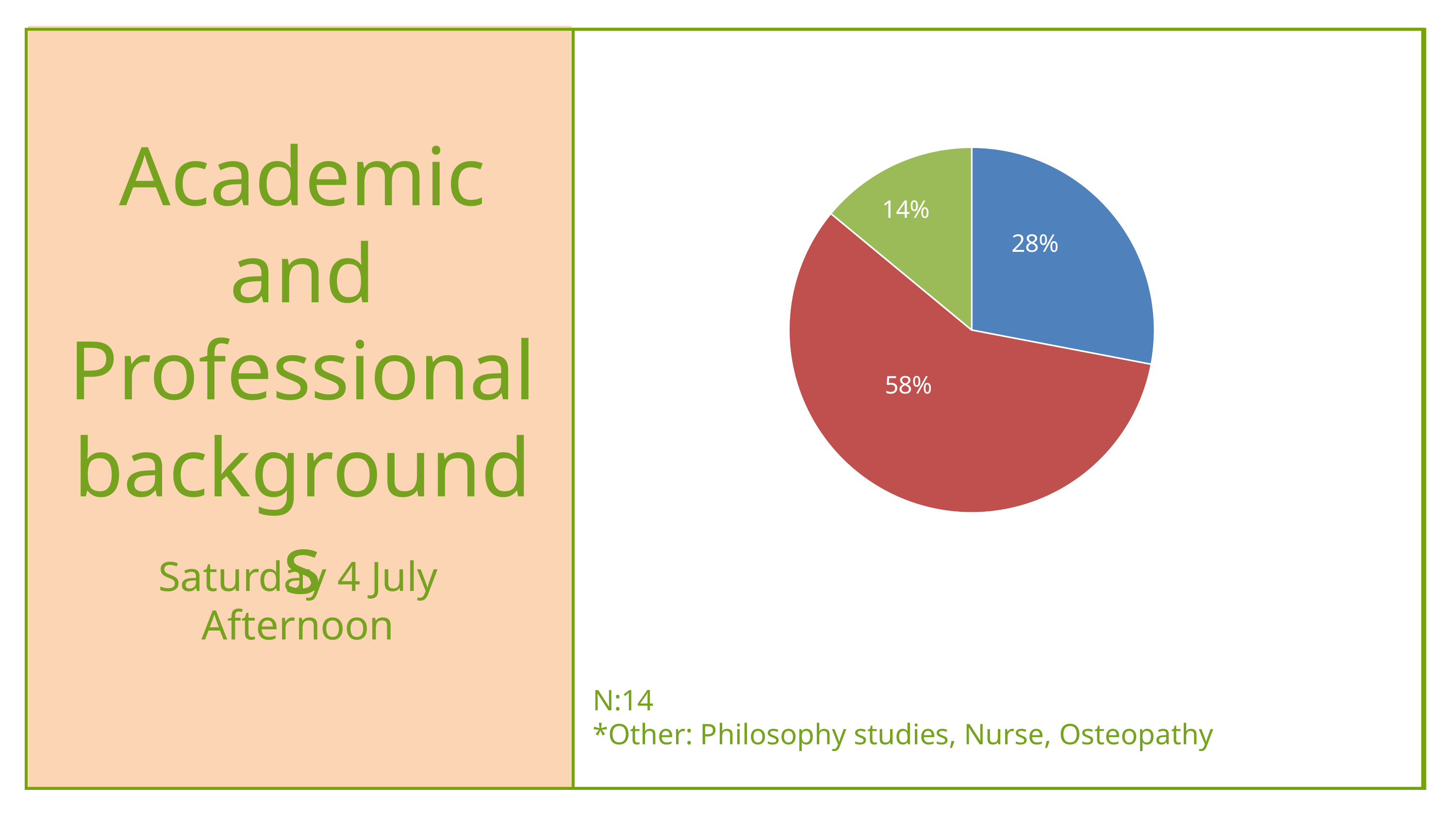
What is the difference in percentage points between the blue slice and the green slice? 14 What percentage is shown on the green slice of the pie chart? 14% Which colour slice is the smallest in the pie chart? green What kind of chart is shown on the slide? pie chart What is the difference in percentage points between the red slice and the blue slice? 30 Which is larger in the pie chart, the blue slice or the green slice? blue What percentage is shown on the blue slice of the pie chart? 28% What percentage is shown on the red slice of the pie chart? 58% What sample size (N) is stated below the pie chart? N:14 Which colour slice is the largest in the pie chart? red How many slices does the pie chart have? 3 Is the red slice's share of the pie greater or less than 50%? greater